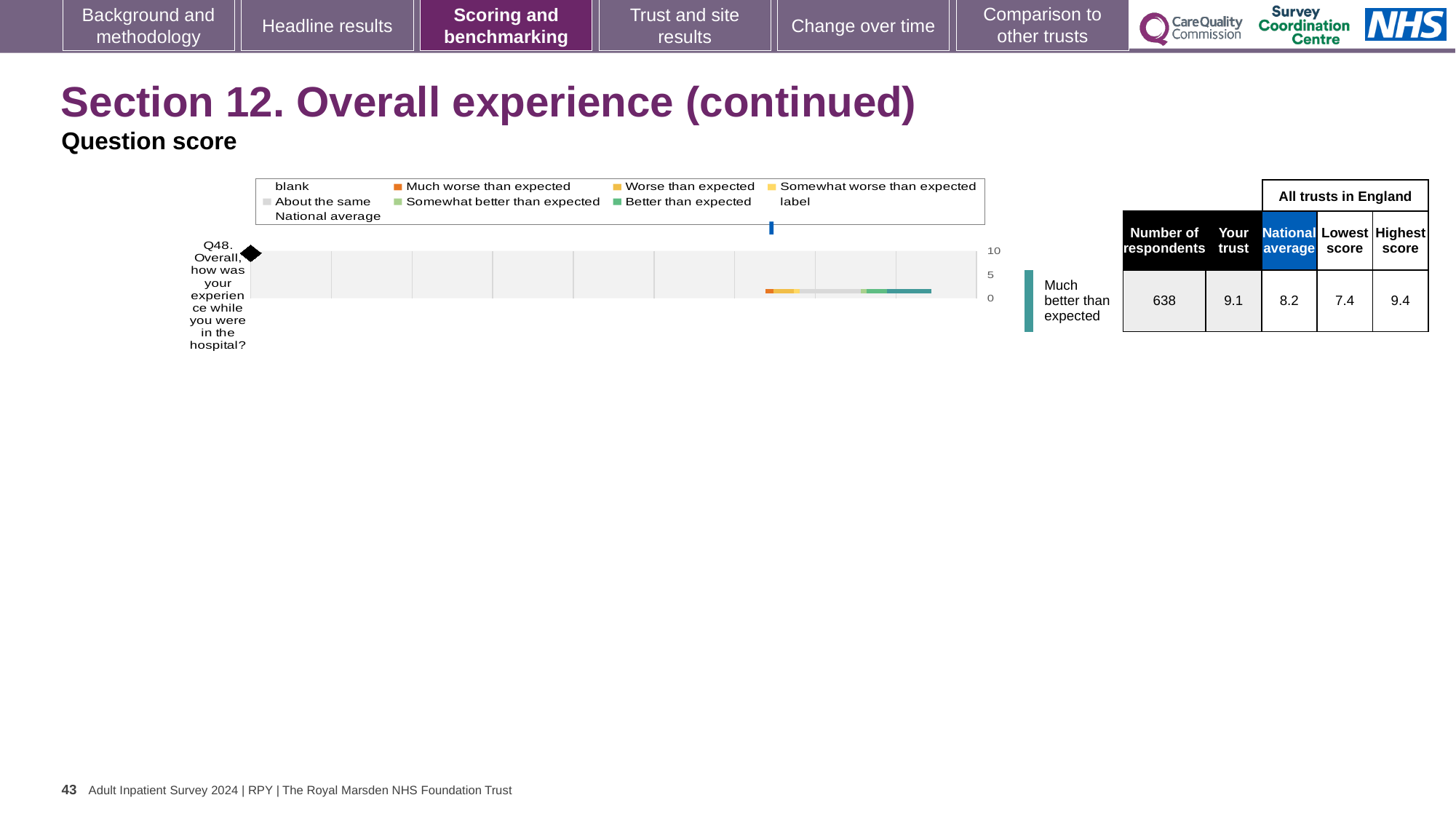
What is the difference between the highest score and the lowest score for Q48 in the table beside the chart? 2.0 In the table beside the chart, what is the national average score for Q48? 8.2 For Q48, which is larger: the 'Your trust' score or the national average? Your trust How many survey questions are plotted in the chart? 1 In the table beside the chart, what is the highest score among all trusts in England for Q48? 9.4 What is the highest value shown on the chart's score axis? 10 In the table beside the chart, what is the 'Your trust' score for Q48? 9.1 Which benchmark category is shown next to the chart for Q48? Much better than expected Which question number is plotted in the chart? Q48 What kind of chart is used to show the Q48 question score? bar chart How many respondents answered Q48 according to the table beside the chart? 638 In the table beside the chart, what is the lowest score among all trusts in England for Q48? 7.4